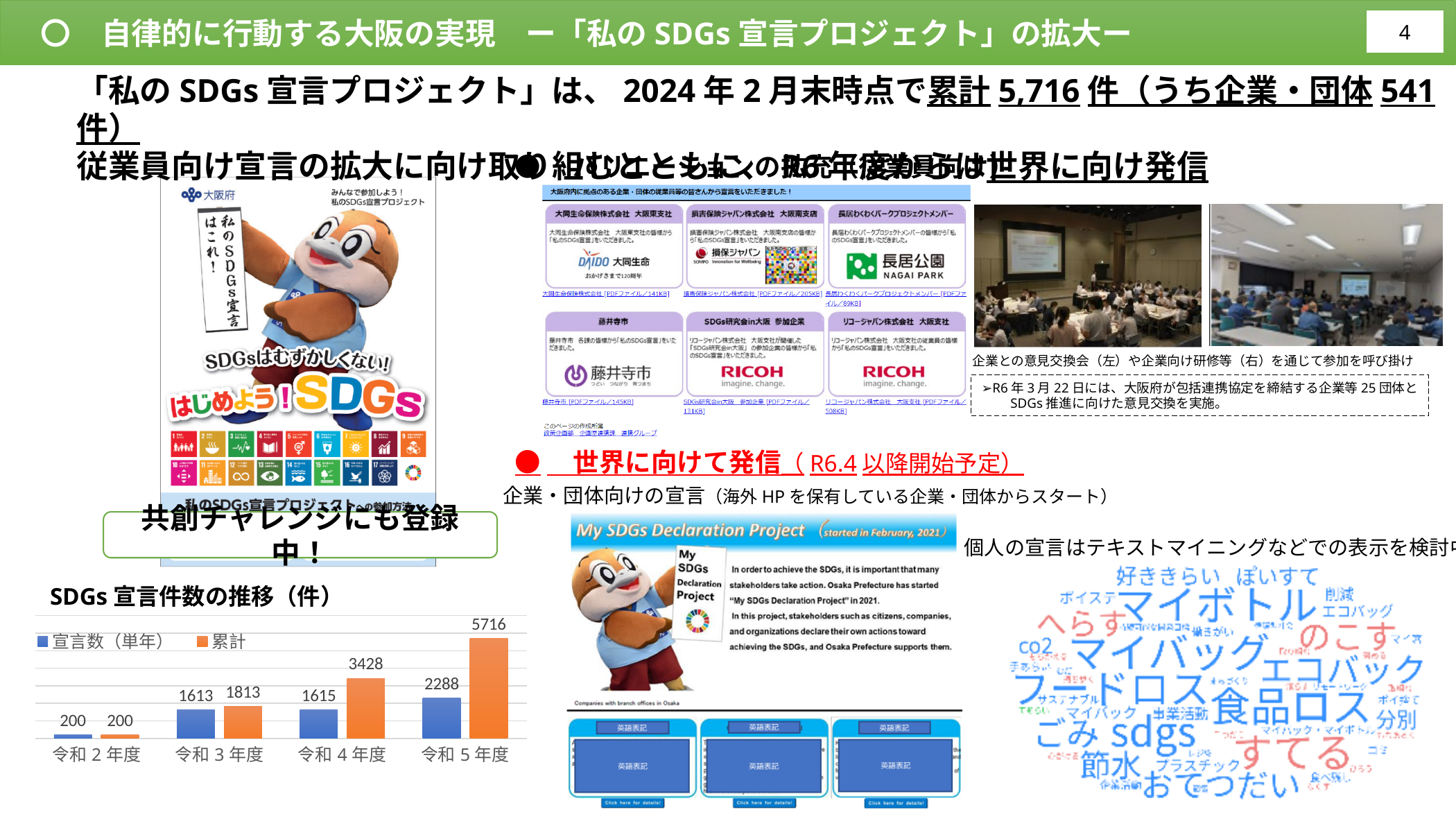
What kind of chart is the SDGs 宣言件数の推移 chart? bar chart What is the 累計 value for 令和4年度 in the SDGs 宣言件数の推移 chart? 3428 Which fiscal year has the lowest 累計 value in the SDGs 宣言件数の推移 chart? 令和2年度 In the SDGs 宣言件数の推移 chart, what is the difference between the 累計 values for 令和5年度 and 令和4年度? 2288 What is the title of the chart on the slide? SDGs 宣言件数の推移（件） What is the 宣言数（単年） value for 令和3年度 in the SDGs 宣言件数の推移 chart? 1613 Which fiscal year has the highest 宣言数（単年） value in the SDGs 宣言件数の推移 chart? 令和5年度 In the SDGs 宣言件数の推移 chart, do the 累計 values rise or fall from 令和2年度 to 令和5年度? rise What is the 累計 value for 令和5年度 in the SDGs 宣言件数の推移 chart? 5716 How many series does the legend of the SDGs 宣言件数の推移 chart list? 2 How many fiscal-year categories are shown on the x axis of the SDGs 宣言件数の推移 chart? 4 In the SDGs 宣言件数の推移 chart, which is larger: the 宣言数（単年） value for 令和4年度 or for 令和5年度? 令和5年度